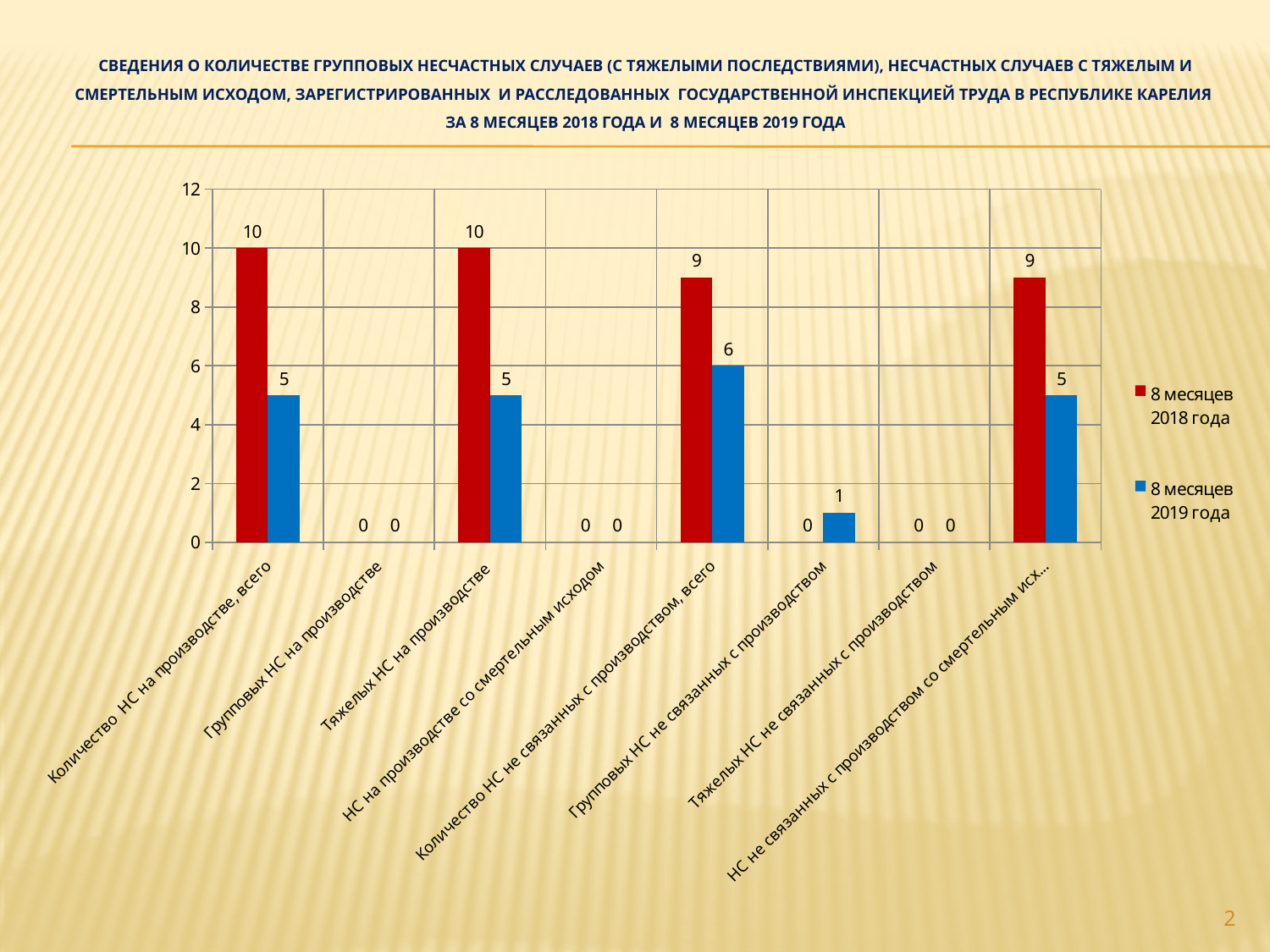
What is the value for "Тяжелых НС на производстве" for 8 месяцев 2019 года? 5 Which colour represents the series "8 месяцев 2019 года"? blue How many categories are shown on the x axis? 8 What is the value for "Групповых НС на производстве" for 8 месяцев 2018 года? 0 What is the difference between the 8 месяцев 2018 года and 8 месяцев 2019 года values for "Количество НС не связанных с производством, всего"? 3 What is the value for "Групповых НС не связанных с производством" for 8 месяцев 2019 года? 1 Which is larger for "Тяжелых НС на производстве": the value for 8 месяцев 2018 года or for 8 месяцев 2019 года? 8 месяцев 2018 года What is the value for "Количество НС на производстве, всего" for 8 месяцев 2018 года? 10 How many series does the legend list? 2 What kind of chart is shown on the slide? bar chart What is the value for "Количество НС не связанных с производством, всего" for 8 месяцев 2019 года? 6 What is the value for "Количество НС на производстве, всего" for 8 месяцев 2019 года? 5